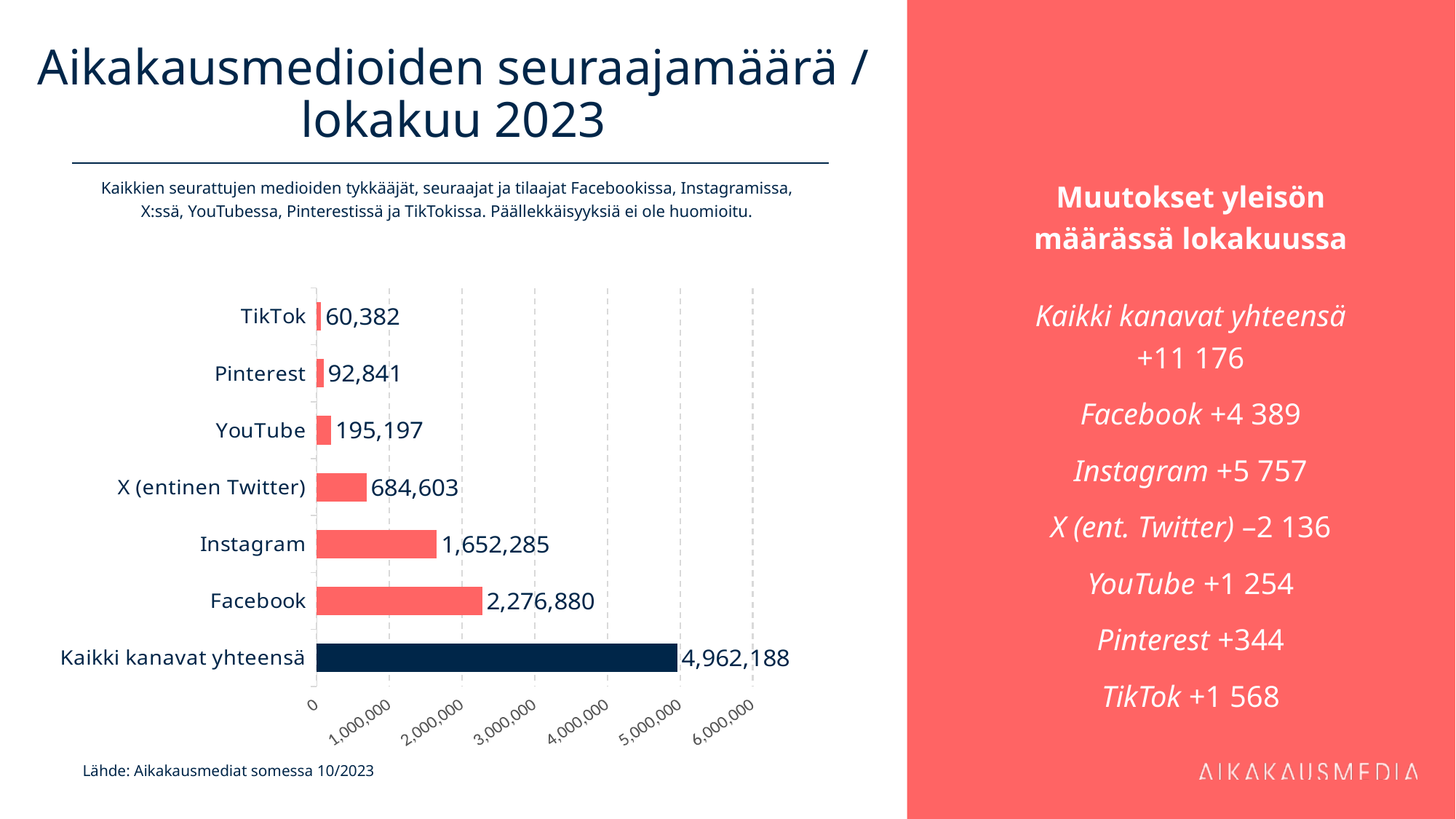
What is the value for Facebook? 2,276,880 What kind of chart is shown on the slide? bar chart Which is larger, the value for YouTube or the value for Pinterest? YouTube What is the value for X (entinen Twitter)? 684,603 Which individual channel (excluding the total bar) has the highest value? Facebook What is the value for Kaikki kanavat yhteensä? 4,962,188 How many categories are shown in the chart? 7 Which category has the lowest value? TikTok What is the difference between the values for Facebook and Instagram? 624,595 What is the value for TikTok? 60,382 What is the value for Instagram? 1,652,285 Is the value for X (entinen Twitter) greater or less than 1,000,000? less